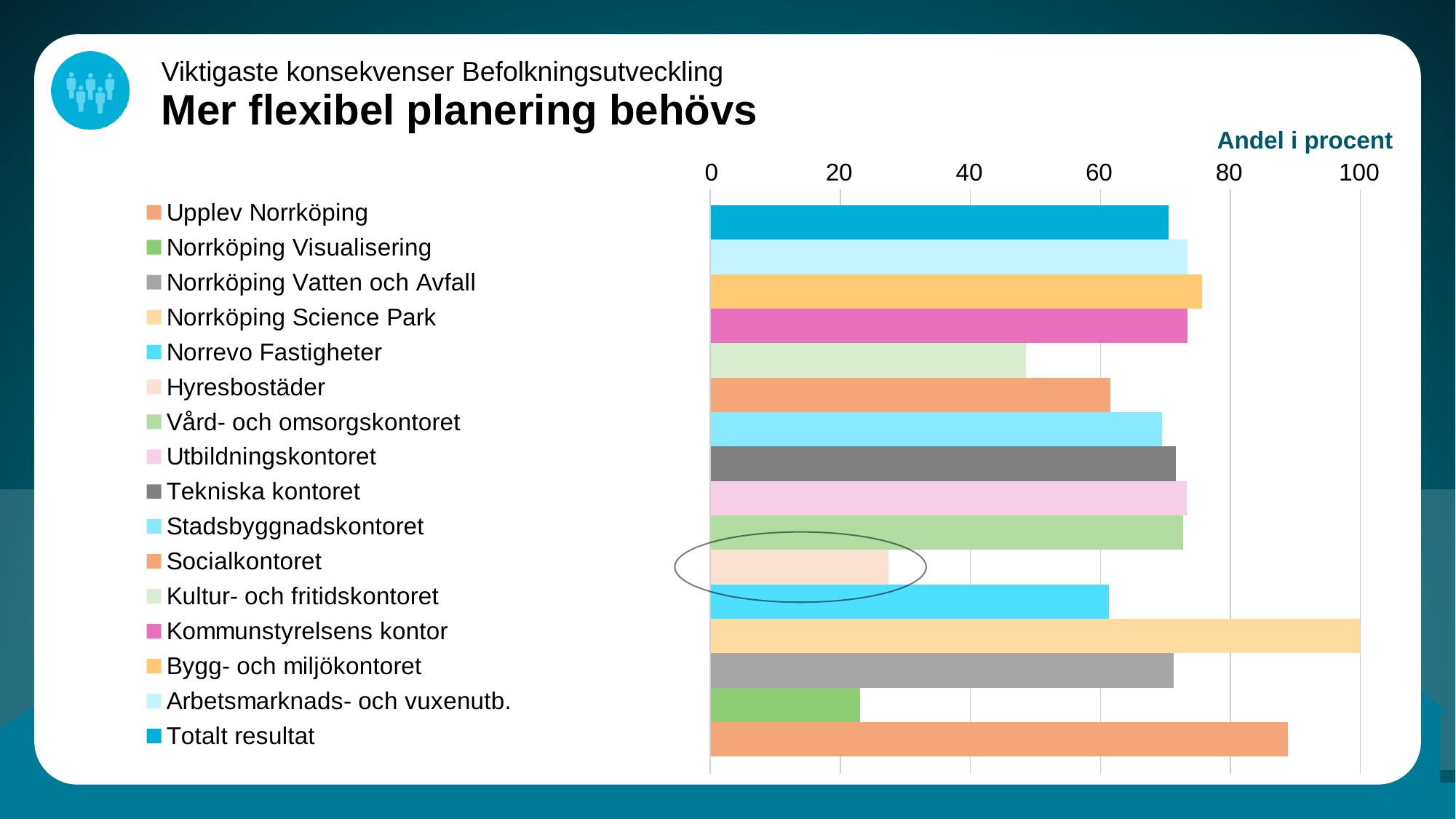
Is the value for Hyresbostäder greater or less than 40? less Is the value for Totalt resultat greater or less than 60? greater How many categories (bars) does the chart show? 16 What kind of chart is shown on the slide? Bar chart What label is shown above the horizontal axis of the chart? Andel i procent Which category has the highest value in the chart? Norrköping Science Park Which has the larger value, Kultur- och fritidskontoret or Socialkontoret? Socialkontoret Which category has the lowest value in the chart? Norrköping Visualisering Is the value for Bygg- och miljökontoret greater or less than 80? less Which has the larger value, Upplev Norrköping or Totalt resultat? Upplev Norrköping